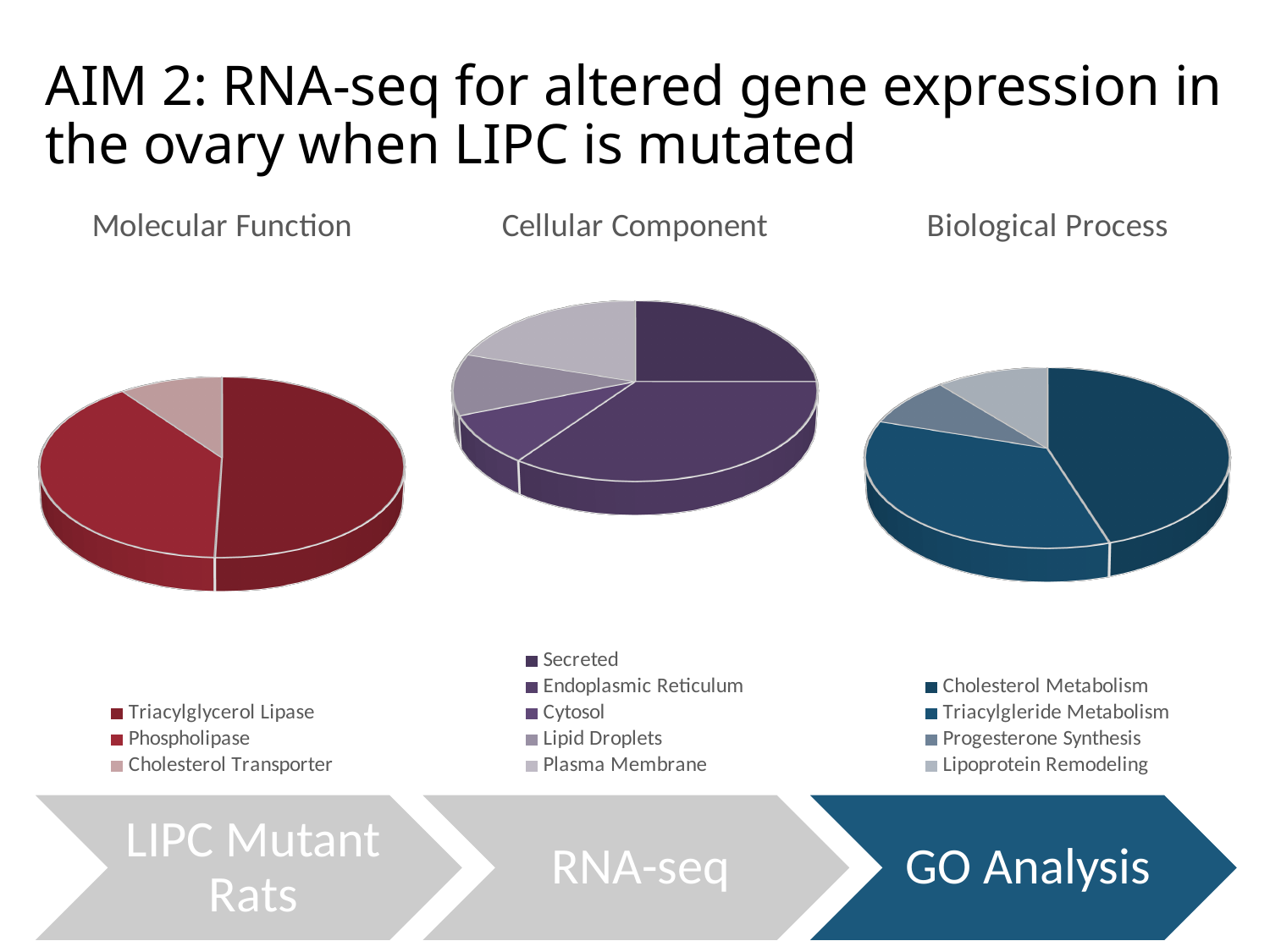
In the Cellular Component chart, which category has the largest slice? Endoplasmic Reticulum How many entries does the legend of the Cellular Component chart list? 5 What is the title of the chart on the right of the slide? Biological Process In the Biological Process chart, which slice is larger, Cholesterol Metabolism or Progesterone Synthesis? Cholesterol Metabolism How many slices does the Biological Process pie chart have? 4 How many pie charts are shown on the slide? 3 In the Cellular Component chart, which slice is larger, Secreted or Cytosol? Secreted What kind of chart is the Molecular Function chart? pie chart How many slices does the Molecular Function pie chart have? 3 In the Molecular Function chart, which category has the largest slice? Triacylglycerol Lipase In the Molecular Function chart, which category has the smallest slice? Cholesterol Transporter In the Molecular Function chart, which slice is larger, Phospholipase or Cholesterol Transporter? Phospholipase